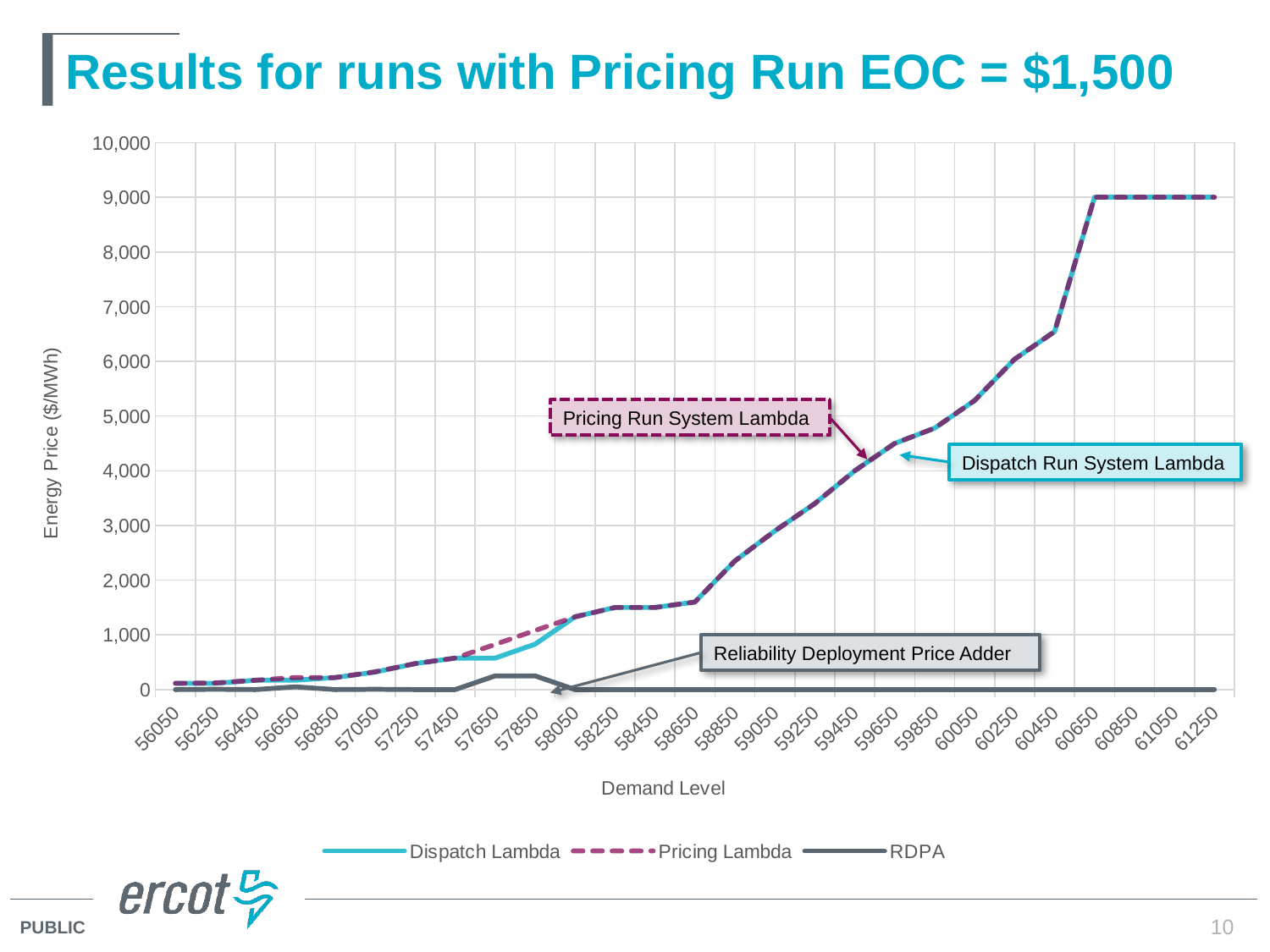
Is the value for RDPA at demand level 59050 greater or less than 1,000? less At demand level 57850, which is higher: Pricing Lambda or Dispatch Lambda? Pricing Lambda At demand level 60650, which is higher: Pricing Lambda or RDPA? Pricing Lambda How many series does the legend list? 3 Is the value for Dispatch Lambda at demand level 60450 greater or less than 6,000? greater Is the value for Dispatch Lambda at demand level 56050 greater or less than 1,000? less Does the Pricing Lambda series generally rise or fall as Demand Level increases? rise What is the title of the x axis? Demand Level What are the three series named in the legend? Dispatch Lambda, Pricing Lambda, RDPA Which series stays lowest across the whole range of demand levels? RDPA What kind of chart is shown on the slide? line chart